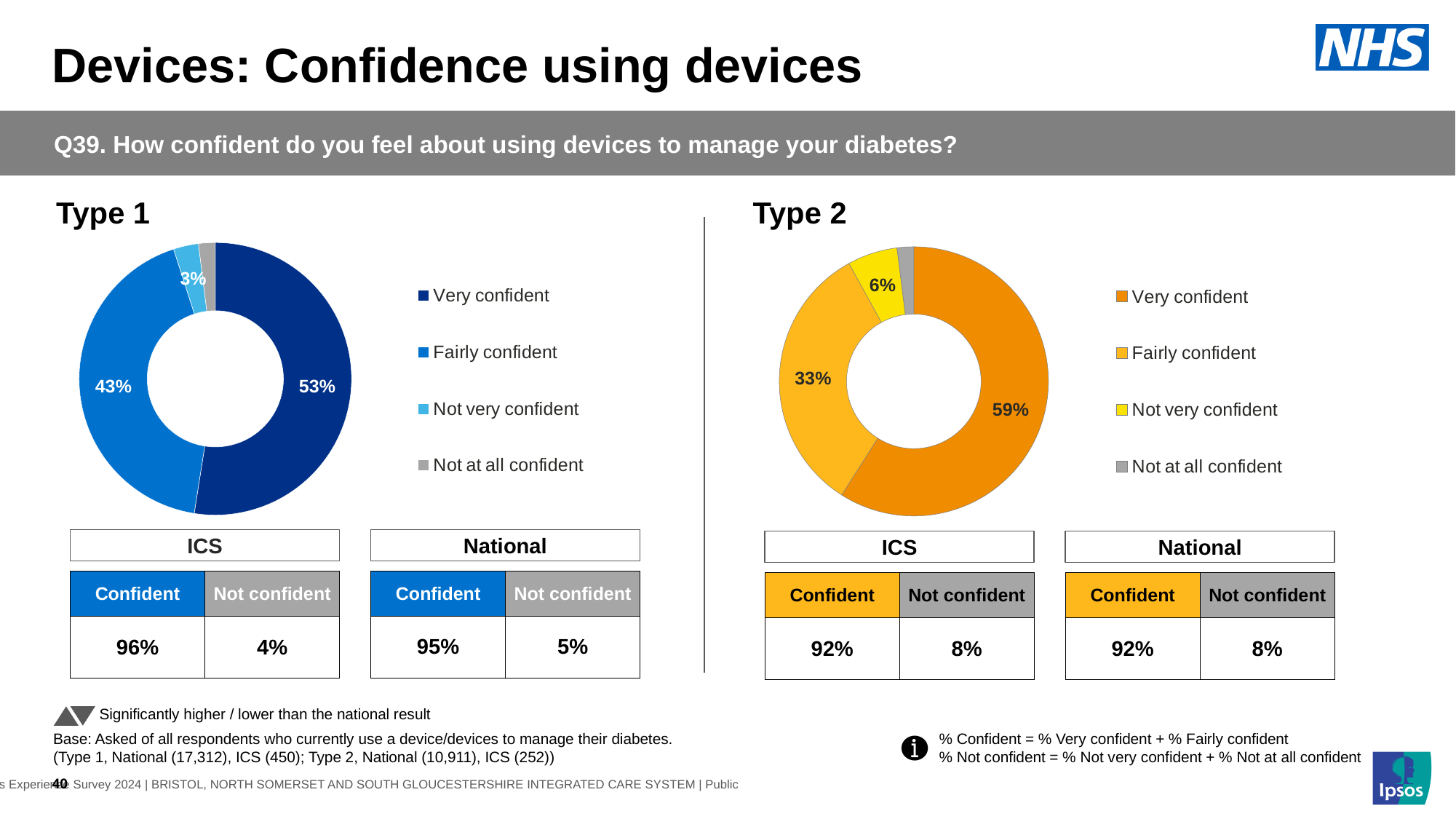
What kind of chart is used for Type 1? Donut chart In the Type 1 chart, what is the difference between the very confident and fairly confident percentages? 10% In the Type 2 chart, what percentage of respondents are not very confident? 6% In the Type 2 chart, what colour represents the 'Not very confident' category? Yellow In the Type 1 chart, which category has the largest share? Very confident In the Type 2 chart, which category has the smallest share? Not at all confident In the Type 2 chart, what is the difference between the very confident and fairly confident percentages? 26% How many categories does the legend of the Type 2 chart list? 4 In the Type 1 chart, what percentage of respondents are fairly confident? 43% In the Type 2 chart, what percentage of respondents are very confident? 59% Which is larger: the very confident share in the Type 1 chart or in the Type 2 chart? Type 2 In the Type 1 chart, what percentage of respondents are very confident? 53%